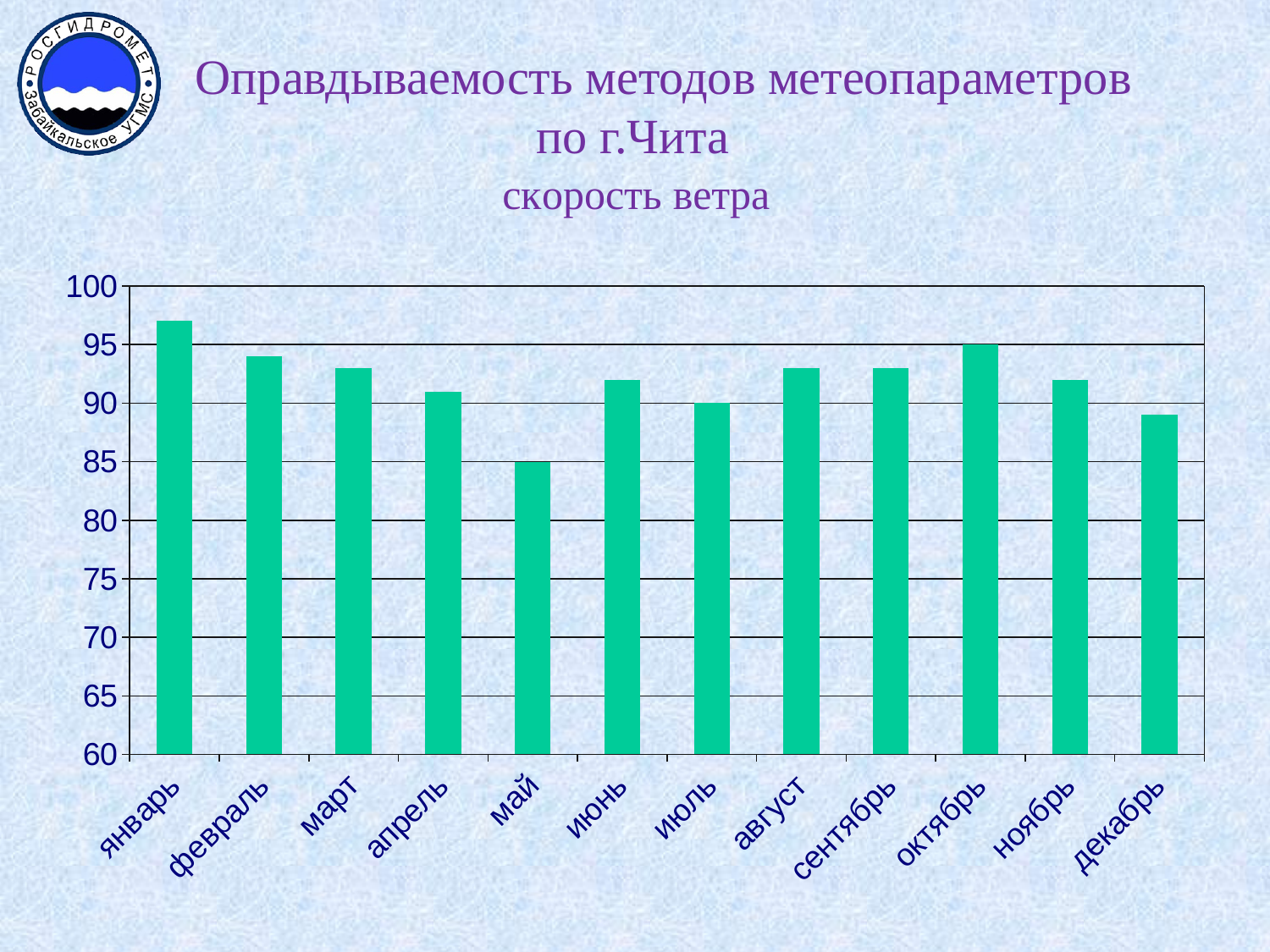
What is the value for октябрь in the chart? 95 Is the value for декабрь greater or less than 90? less What is the value for май in the chart? 85 Is the value for январь greater or less than 95? greater What kind of chart is shown on the slide? bar chart What meteorological parameter does the chart subtitle say it covers? скорость ветра Which month has the lowest bar in the chart? май Which month has the highest bar in the chart? январь How many months are shown on the x axis of the chart? 12 What is the value for июль in the chart? 90 Do the values rise or fall from январь to май? fall Which is larger, the value for октябрь or the value for декабрь? октябрь